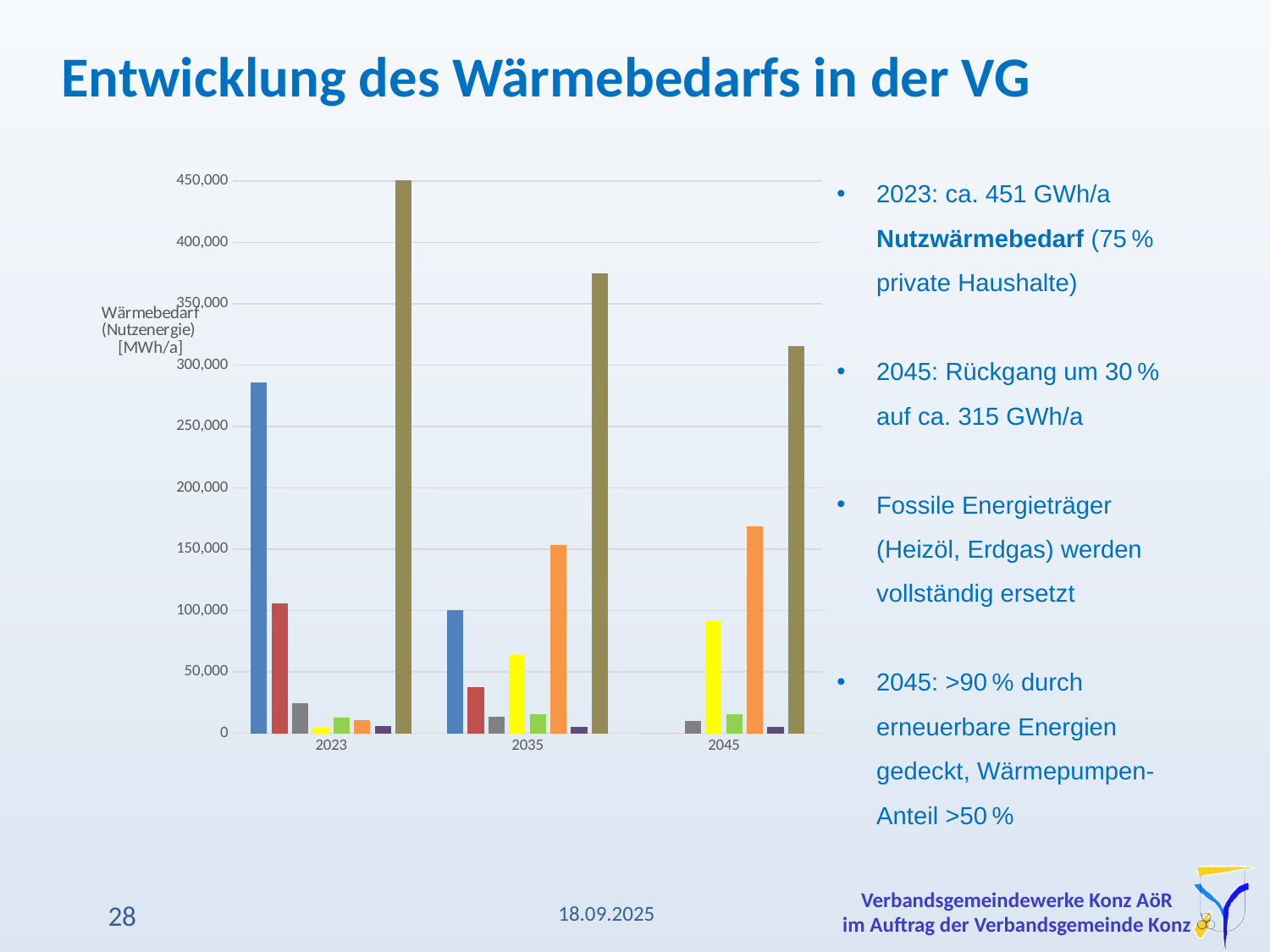
Is the value of the tallest (olive) bar for 2045 greater or less than 300,000? greater Is the value of the blue bar for 2023 greater or less than 250,000? greater Is the value of the tallest (olive) bar for 2023 greater or less than 400,000? greater What is the title of the slide containing the chart? Entwicklung des Wärmebedarfs in der VG Do the tallest (olive) bars rise or fall from 2023 to 2045? fall How many year categories are shown on the x axis of the chart? 3 What is the label of the vertical axis of the chart? Wärmebedarf (Nutzenergie) [MWh/a] In which year is the tallest (olive) bar the highest? 2023 What kind of chart is shown on the slide? bar chart